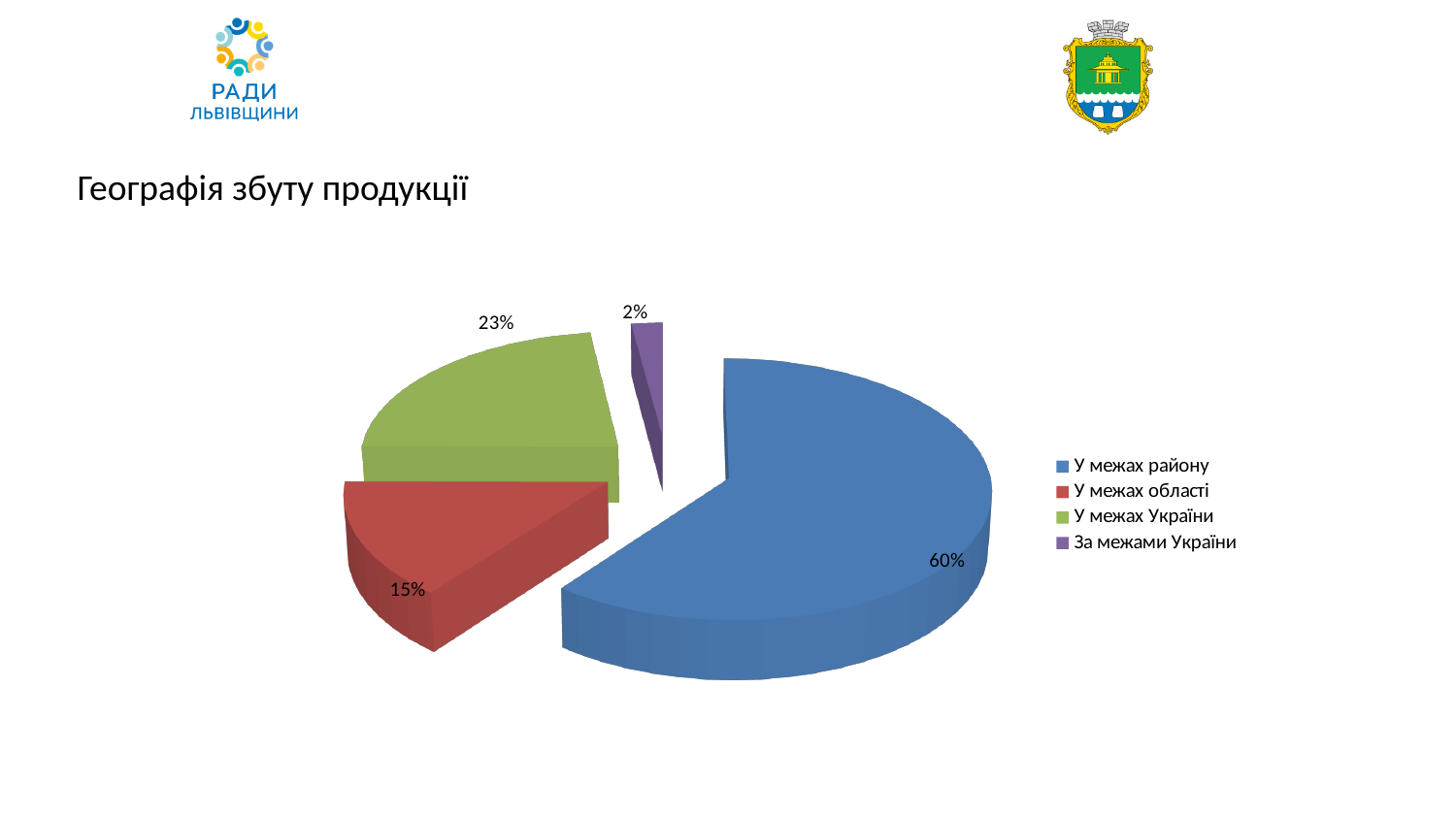
What is the difference between the values for "У межах району" and "У межах України"? 37% What is the difference between the values for "У межах України" and "У межах області"? 8% What kind of chart is shown on the slide? Pie chart Which category has the largest slice of the pie? У межах району What is the value shown for "У межах області"? 15% How many categories does the pie chart show? 4 What colour is the slice for "У межах області"? Red What is the value shown for "За межами України"? 2% Which category has the smallest slice of the pie? За межами України What is the value shown for "У межах України"? 23% Which is larger, the value for "У межах області" or the value for "У межах України"? У межах України What share of the pie does "У межах району" have? 60%